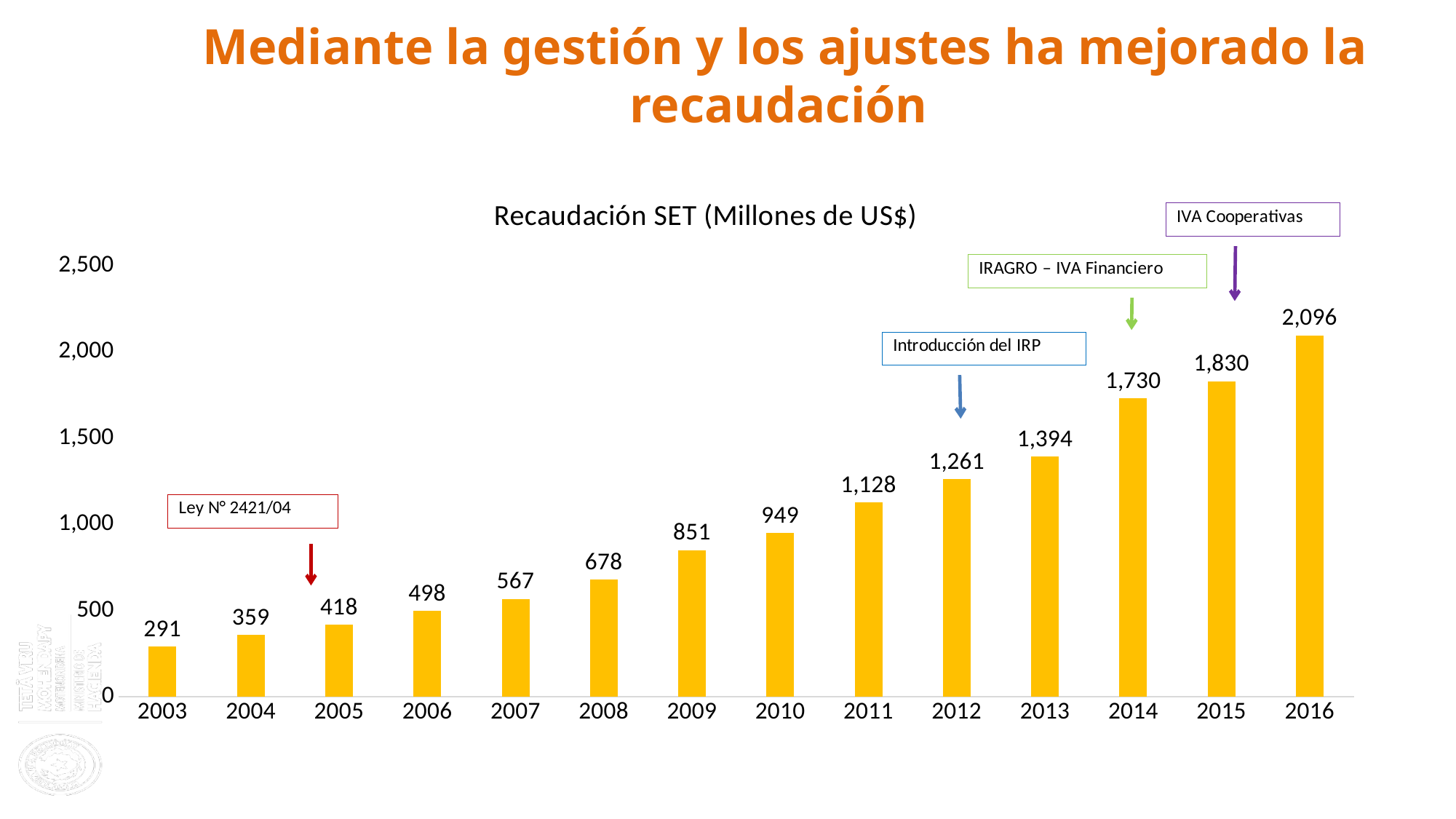
What is the value for 2003? 291 Is the value for 2013 greater or less than 1,500? less What is the difference between the values for 2012 and 2011? 133 What is the value for 2014? 1,730 How many years are shown on the x axis? 14 What kind of chart is shown? bar chart What is the difference between the values for 2016 and 2015? 266 Which year has the highest value? 2016 Which is larger, the value for 2008 or the value for 2009? 2009 Do the values rise or fall from 2003 to 2016? rise Which year has the lowest value? 2003 What is the value for 2010? 949